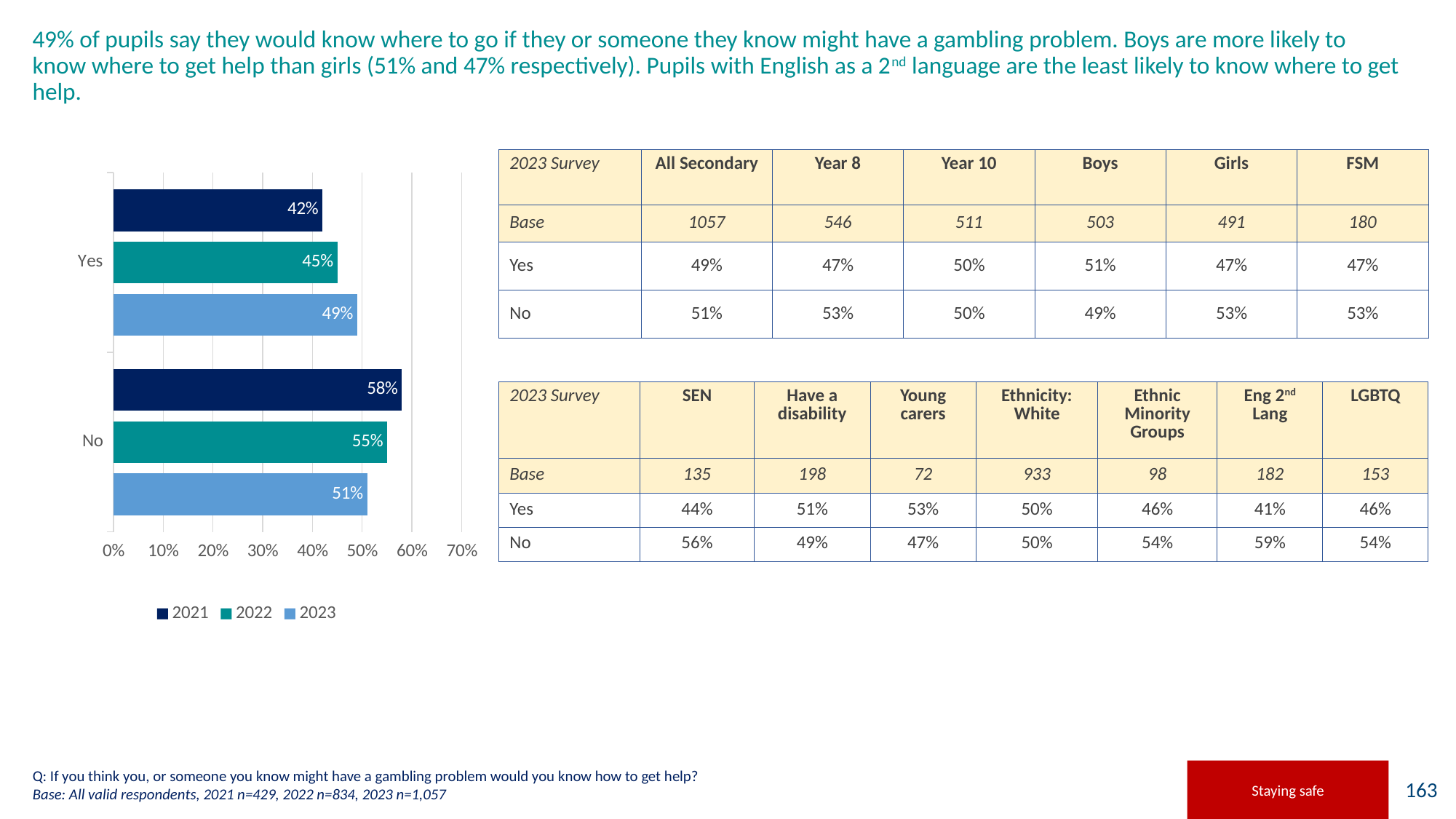
Which colour represents 2022 in the chart? teal Which is larger, the Yes percentage in 2021 or the Yes percentage in 2023? 2023 What kind of chart is shown on the slide? bar chart What percentage of pupils answered Yes in 2023? 49% What percentage of pupils answered Yes in 2022? 45% What percentage of pupils answered No in 2021? 58% Which year has the highest percentage for Yes? 2023 Which year has the lowest percentage for No? 2023 Does the Yes percentage rise or fall from 2021 to 2023? rise How many series does the legend list? 3 How many categories are shown on the chart? 2 What is the difference between the No and Yes percentages in 2021? 16%